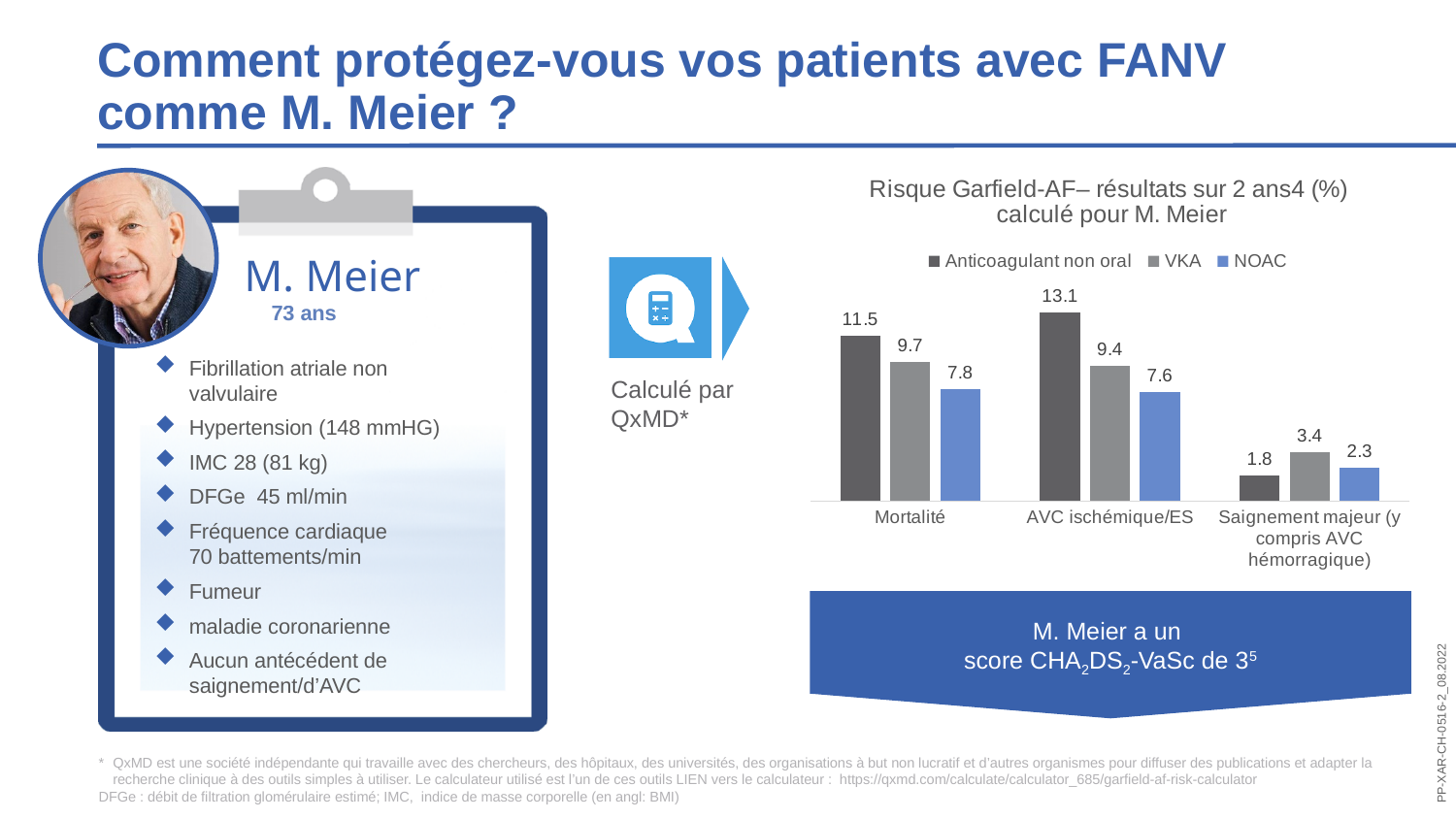
Which is larger: the VKA value for Mortalité or the VKA value for AVC ischémique/ES? VKA value for Mortalité What is the value for NOAC in the AVC ischémique/ES category? 7.6 What is the difference between the Anticoagulant non oral and NOAC values in the Mortalité category? 3.7 How many series does the legend list? 3 What is the difference between the VKA and NOAC values in the Saignement majeur (y compris AVC hémorragique) category? 1.1 How many categories are shown on the x axis of the chart? 3 What kind of chart is shown on the slide? Bar chart Which series has the highest value in the AVC ischémique/ES category? Anticoagulant non oral What is the value for VKA in the Saignement majeur (y compris AVC hémorragique) category? 3.4 Which series has the lowest value in the Saignement majeur (y compris AVC hémorragique) category? Anticoagulant non oral What is the value for Anticoagulant non oral in the Mortalité category? 11.5 What is the title of the chart? Risque Garfield-AF– résultats sur 2 ans4 (%) calculé pour M. Meier